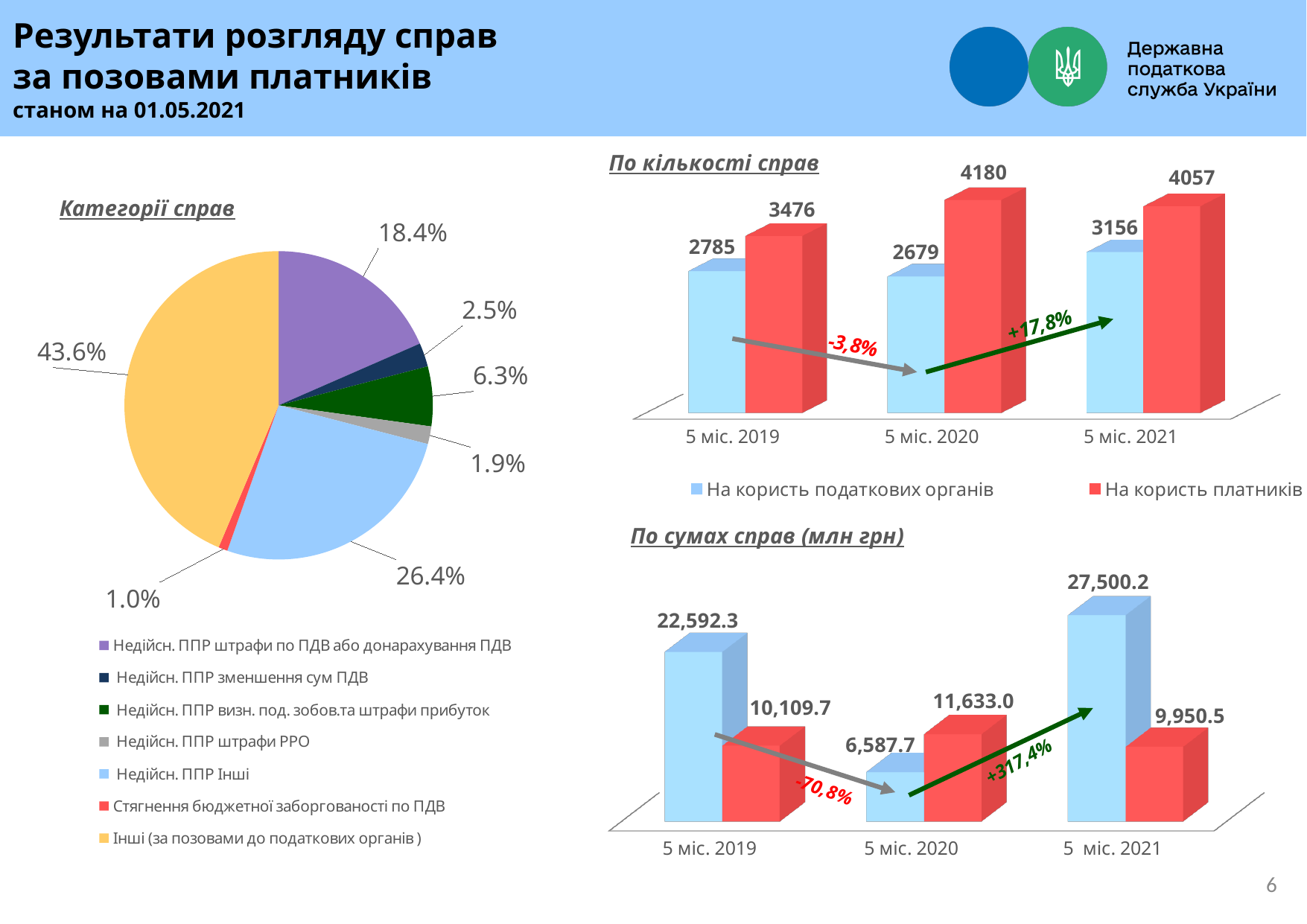
In the pie chart 'Категорії справ', what share does 'Інші (за позовами до податкових органів)' have? 43.6% In the chart 'По кількості справ', what is the value for 'На користь податкових органів' in 5 міс. 2021? 3156 In the chart 'По сумах справ (млн грн)', which period has the lowest blue bar? 5 міс. 2020 In the chart 'По сумах справ (млн грн)', what is the value of the blue bar for 5 міс. 2021? 27,500.2 In the chart 'По кількості справ', how many series does the legend list? 2 In the chart 'По сумах справ (млн грн)', which is larger in 5 міс. 2020: the blue bar or the red bar? The red bar (11,633.0) In the chart 'По кількості справ', what is the difference between 'На користь платників' and 'На користь податкових органів' in 5 міс. 2019? 691 In the pie chart 'Категорії справ', which category has the smallest share? Стягнення бюджетної заборгованості по ПДВ What kind of chart is 'По кількості справ'? Bar chart In the pie chart 'Категорії справ', what share does 'Недійсн. ППР штрафи по ПДВ або донарахування ПДВ' have? 18.4% How many categories does the pie chart 'Категорії справ' show? 7 In the chart 'По кількості справ', what is the value for 'На користь платників' in 5 міс. 2020? 4180